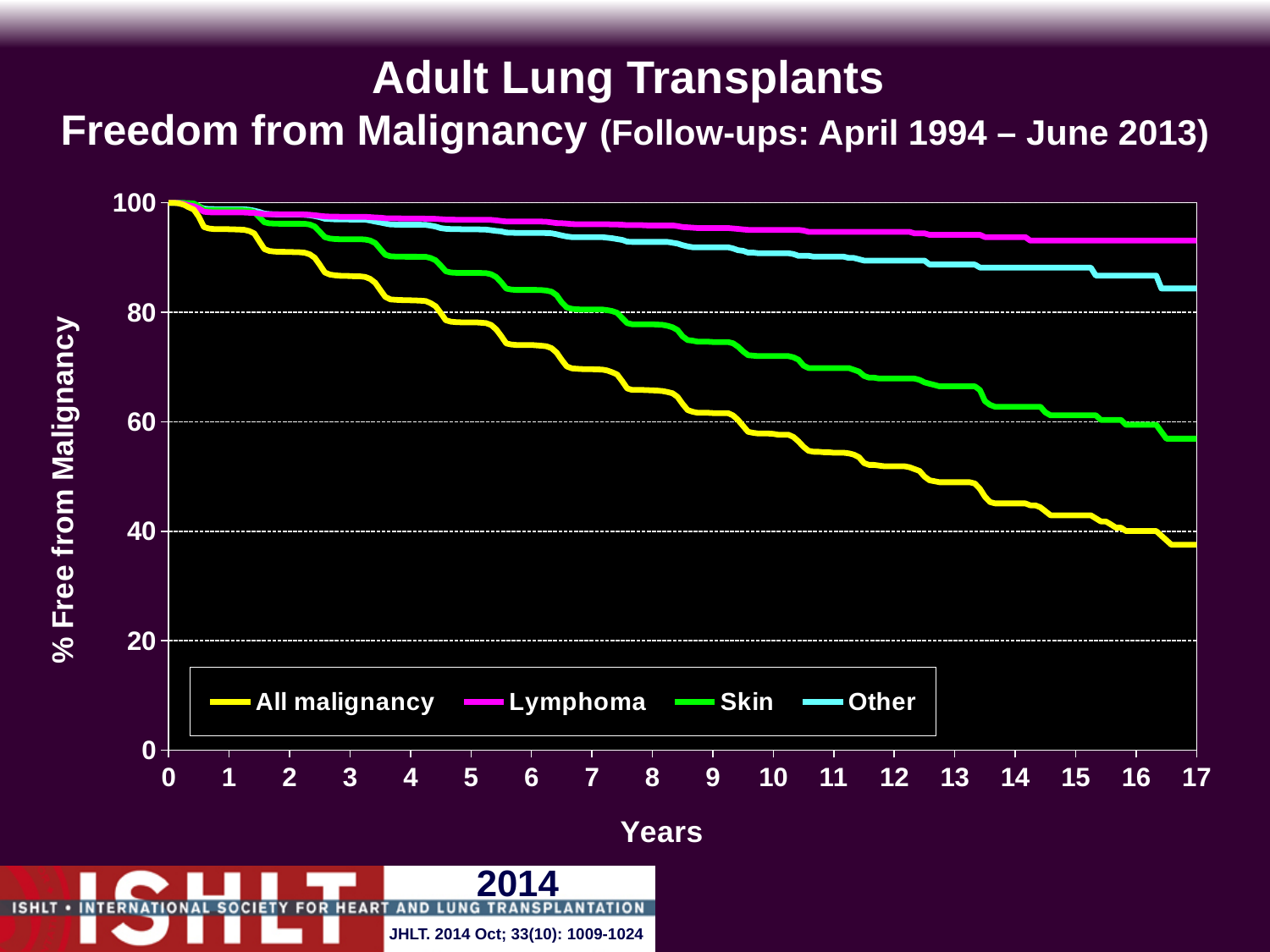
What kind of chart is shown on the slide? Line chart Which series has the lowest % free from malignancy at 17 years? All malignancy At 10 years, which is higher: Skin or All malignancy? Skin How many series does the legend list? 4 Which series has the highest % free from malignancy at 17 years? Lymphoma Is the value for Other at 17 years greater or less than 80? greater At 17 years, which is higher: Lymphoma or Other? Lymphoma What is the label of the y axis? % Free from Malignancy Is the value for Skin at 17 years greater or less than 60? less Is the value for All malignancy at 17 years greater or less than 40? less Do the values for All malignancy rise or fall as years increase? Fall